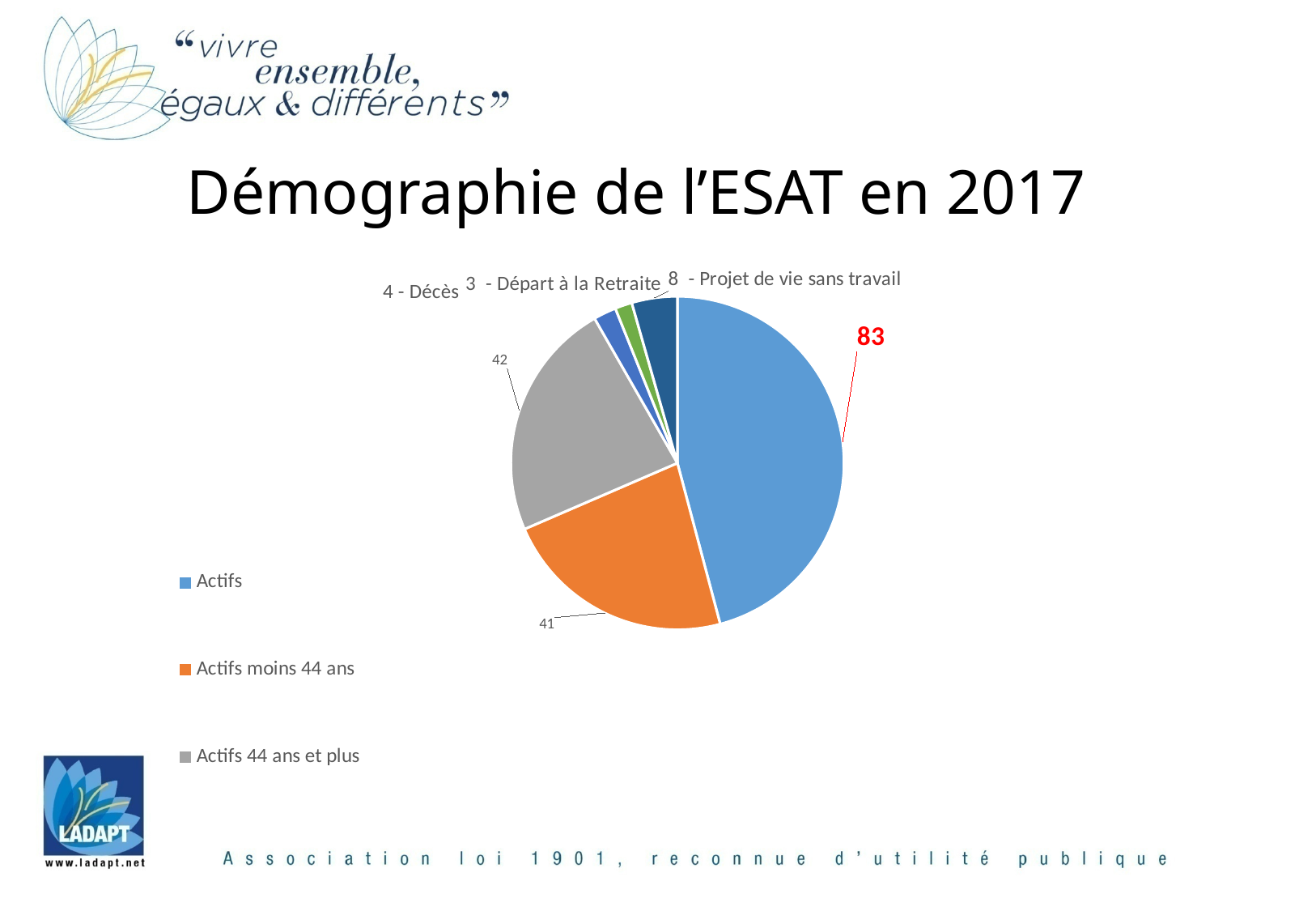
What is the value shown for Décès? 4 What is the value of the Actifs slice in the pie chart? 83 What is the difference between the Actifs value and the Actifs 44 ans et plus value? 41 How many slices does the pie chart have? 6 Which slice of the pie chart has the largest value? Actifs What is the value of the Actifs moins 44 ans slice? 41 What is the value shown for Départ à la Retraite? 3 What is the value of the Actifs 44 ans et plus slice? 42 Which slice of the pie chart has the smallest value? Départ à la Retraite What kind of chart is shown on the slide? Pie chart What is the value shown for Projet de vie sans travail? 8 Which is larger, Actifs moins 44 ans or Actifs 44 ans et plus? Actifs 44 ans et plus